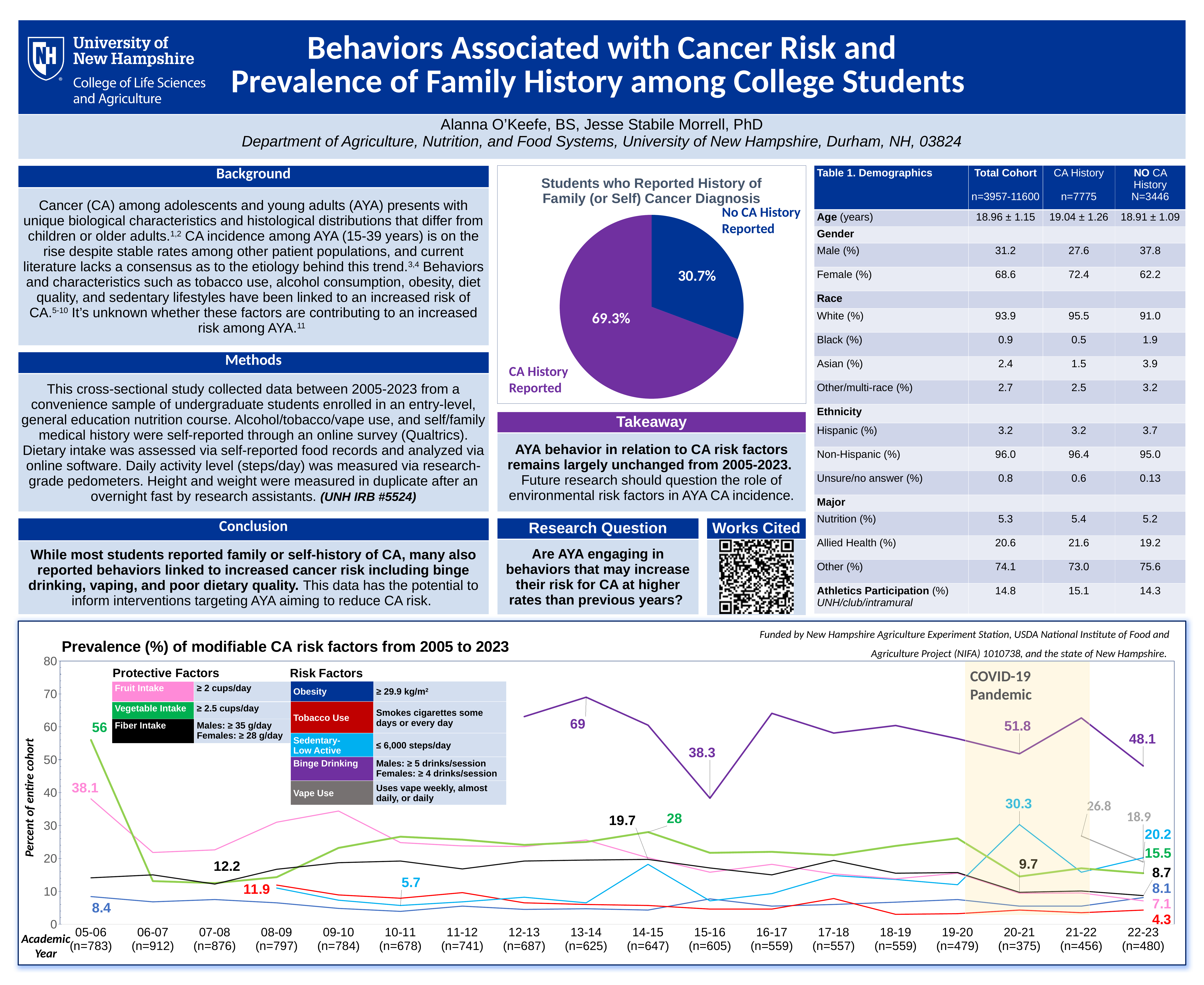
What kind of chart is 'Prevalence (%) of modifiable CA risk factors from 2005 to 2023'? Line chart In the pie chart 'Students who Reported History of Family (or Self) Cancer Diagnosis', what share of students reported a CA history? 69.3% In the chart 'Prevalence (%) of modifiable CA risk factors from 2005 to 2023', what is the Binge Drinking value for 13-14? 69 What kind of chart is 'Students who Reported History of Family (or Self) Cancer Diagnosis'? Pie chart In the chart 'Prevalence (%) of modifiable CA risk factors from 2005 to 2023', how many factors (series) does the legend list? 8 In the chart 'Prevalence (%) of modifiable CA risk factors from 2005 to 2023', what is the difference between the Binge Drinking values for 13-14 and 15-16? 30.7 In the pie chart 'Students who Reported History of Family (or Self) Cancer Diagnosis', which slice is larger: CA History Reported or No CA History Reported? CA History Reported In the chart 'Prevalence (%) of modifiable CA risk factors from 2005 to 2023', does Vegetable Intake rise or fall from 05-06 to 22-23? Fall In the chart 'Prevalence (%) of modifiable CA risk factors from 2005 to 2023', what is the Binge Drinking value for 15-16? 38.3 In the chart 'Prevalence (%) of modifiable CA risk factors from 2005 to 2023', is the Fruit Intake value for 09-10 greater or less than 30? greater In the chart 'Prevalence (%) of modifiable CA risk factors from 2005 to 2023', how many academic years are shown on the x axis? 18 In the chart 'Prevalence (%) of modifiable CA risk factors from 2005 to 2023', what is the Tobacco Use value for 22-23? 4.3